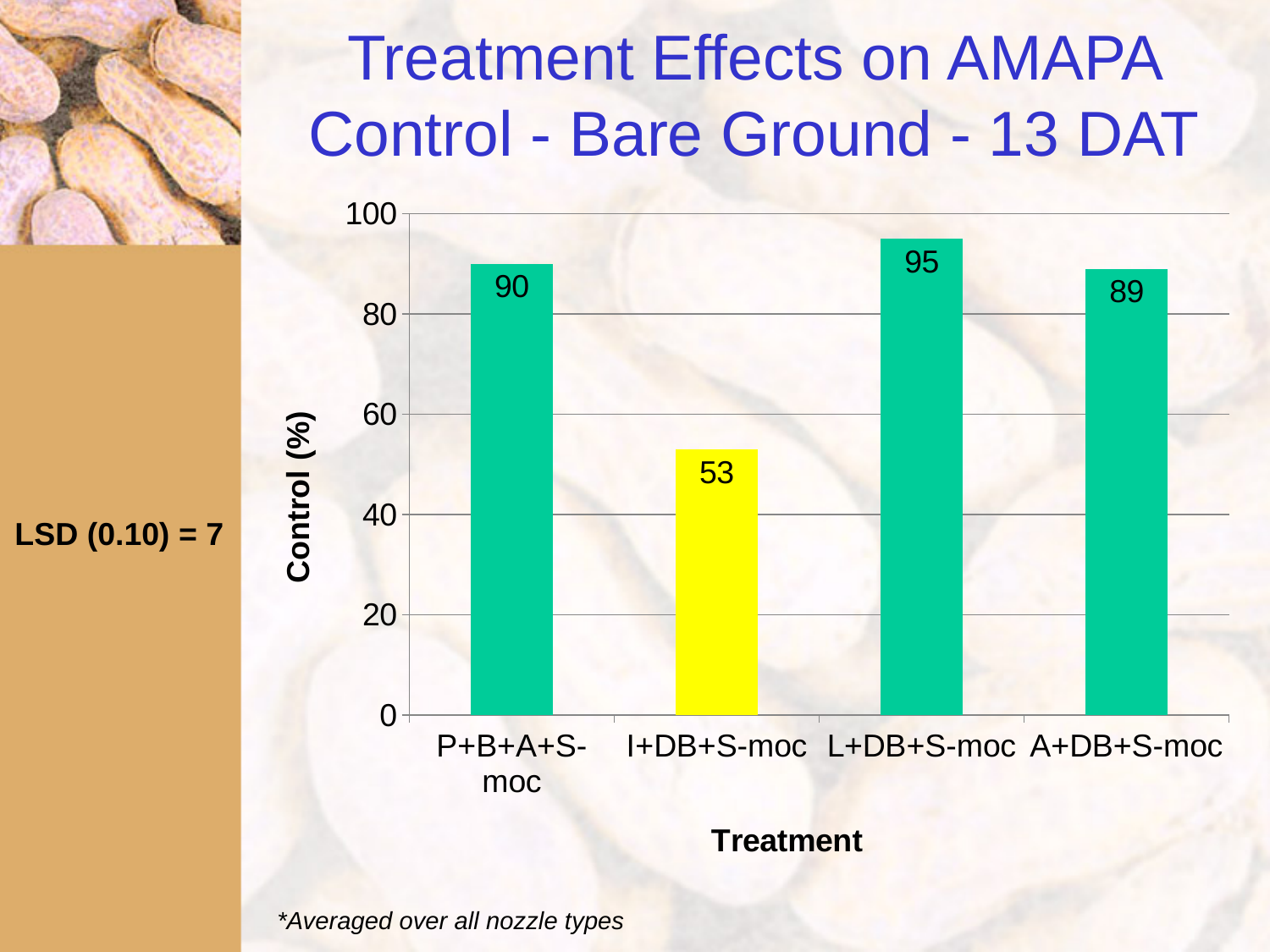
What kind of chart is shown on the slide? bar chart Which treatment has the lowest control (%)? I+DB+S-moc Is the value for I+DB+S-moc greater or less than 60? less What is the control (%) value for the I+DB+S-moc treatment? 53 What is the control (%) value for the L+DB+S-moc treatment? 95 Which treatment has the highest control (%)? L+DB+S-moc Which has a higher control (%): P+B+A+S-moc or I+DB+S-moc? P+B+A+S-moc What is the control (%) value for the P+B+A+S-moc treatment? 90 What is the control (%) value for the A+DB+S-moc treatment? 89 Which bar is coloured yellow rather than green? I+DB+S-moc What is the difference in control (%) between L+DB+S-moc and I+DB+S-moc? 42 How many treatments are shown on the chart? 4